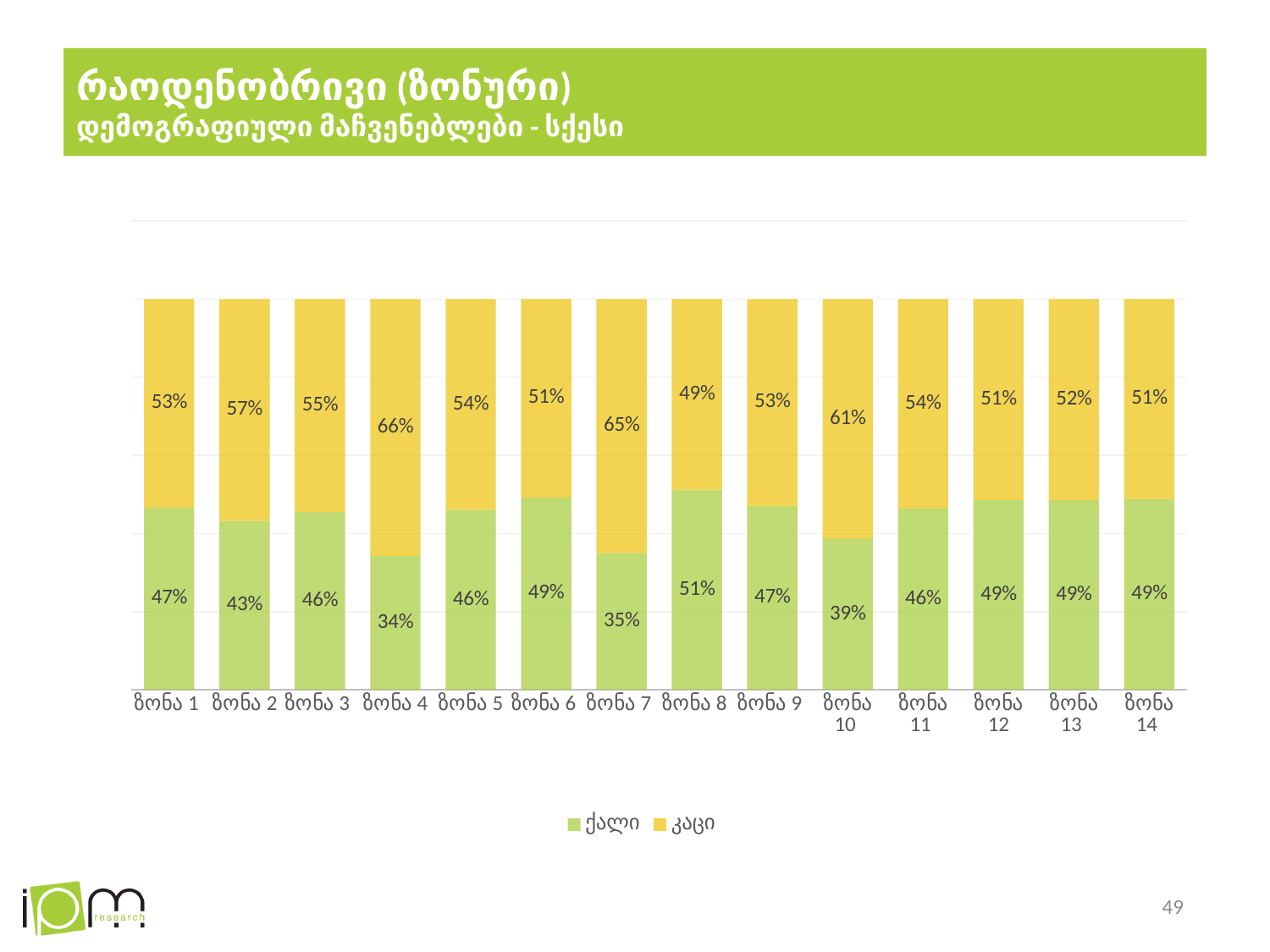
What type of chart is shown on the slide? stacked bar chart What is the value of კაცი for ზონა 10? 61% How many zones (categories) are shown along the x axis? 14 Which zone has the lowest value for ქალი? ზონა 4 Which colour represents კაცი in the chart? yellow Which is larger in ზონა 2: ქალი or კაცი? კაცი What is the value of ქალი for ზონა 4? 34% Which zone has the highest value for კაცი? ზონა 4 What is the difference between კაცი and ქალი in ზონა 7? 30% What is the value of ქალი for ზონა 8? 51% How many series does the legend list? 2 Which is larger in ზონა 8: ქალი or კაცი? ქალი